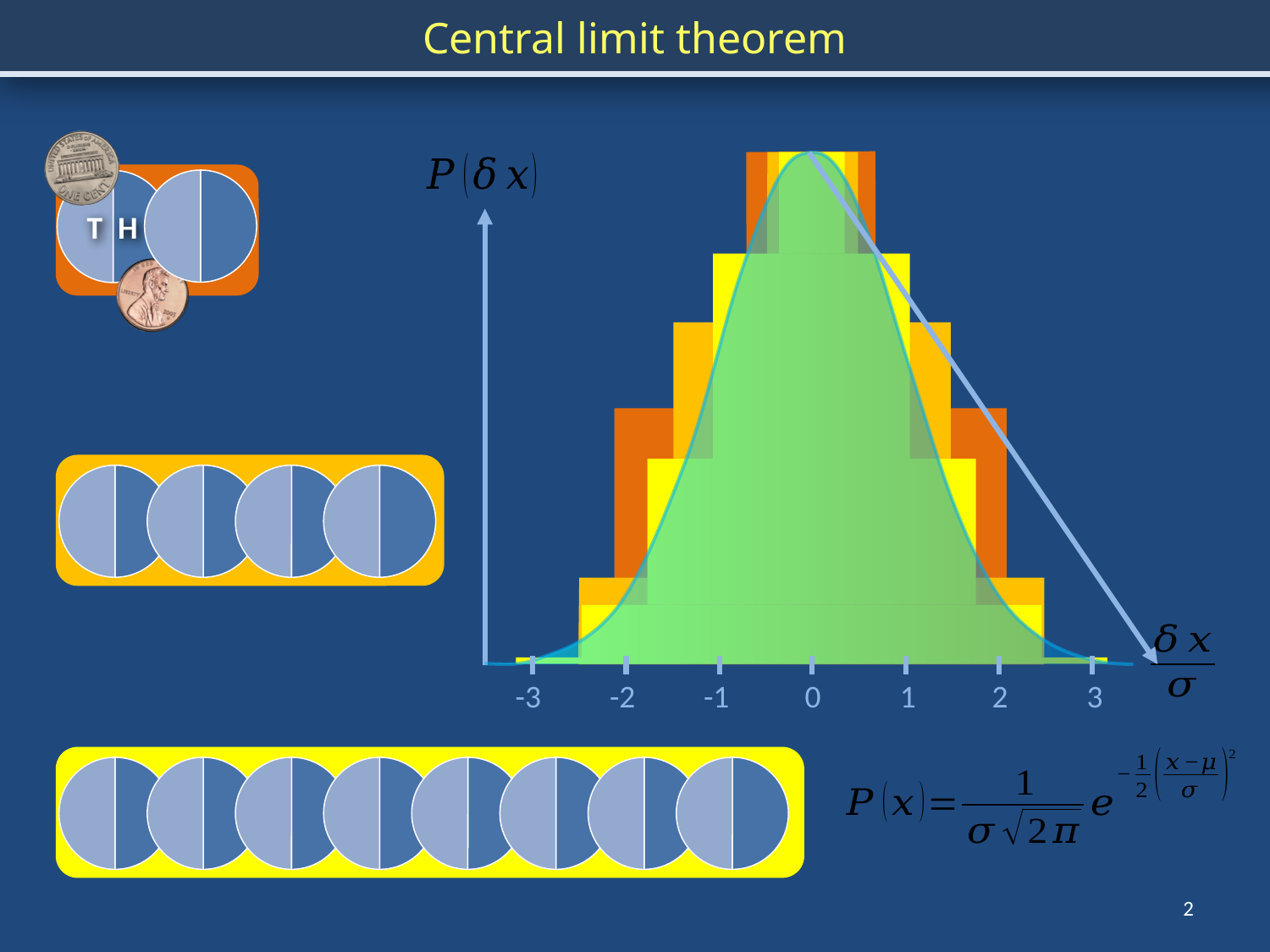
What is the lowest tick value shown on the horizontal axis? -3 What is the highest tick value shown on the horizontal axis? 3 At which horizontal-axis value does the green curve reach its peak? 0 What is the title of the slide containing the chart? Central limit theorem How many tick labels are shown along the horizontal axis? 7 What kind of chart is shown on the slide? A bar chart (histogram) with a curve overlaid Which is taller: the bar centred at -1 or the bar centred at -2? The bar centred at -1 Which is taller: the bar centred at 0 or the bar centred at 2? The bar centred at 0 What label is written on the vertical axis of the chart? P(δx) At which horizontal-axis values is the plotted distribution lowest? -3 and 3 Do the values rise or fall as the horizontal axis goes from 0 to 3? fall Do the values rise or fall as the horizontal axis goes from -3 to 0? rise